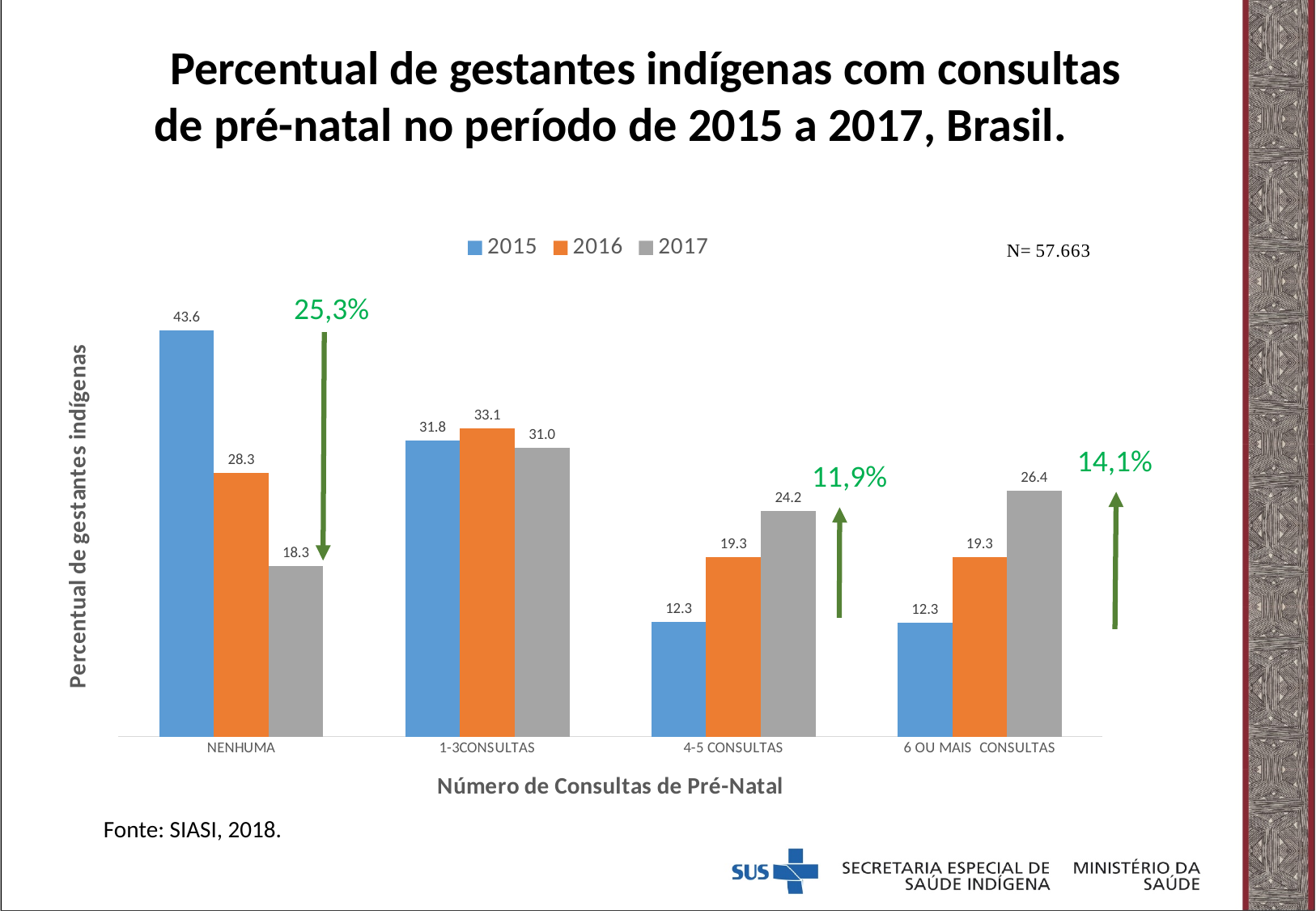
What is the value for 2017 in the 4-5 CONSULTAS category? 24.2 What kind of chart is shown on the slide? bar chart Which is larger in the 1-3CONSULTAS category, the 2015 value or the 2017 value? 2015 Which category has the lowest value for the 2017 series? NENHUMA What is the value for 2015 in the NENHUMA category? 43.6 How many categories are shown on the x axis? 4 What is the x-axis title of the chart? Número de Consultas de Pré-Natal Which category has the highest value for the 2015 series? NENHUMA What is the value for 2016 in the 1-3CONSULTAS category? 33.1 What is the difference between the 2017 and 2015 values in the 6 OU MAIS CONSULTAS category? 14.1 How many series does the legend list? 3 What is the difference between the 2015 and 2017 values in the NENHUMA category? 25.3